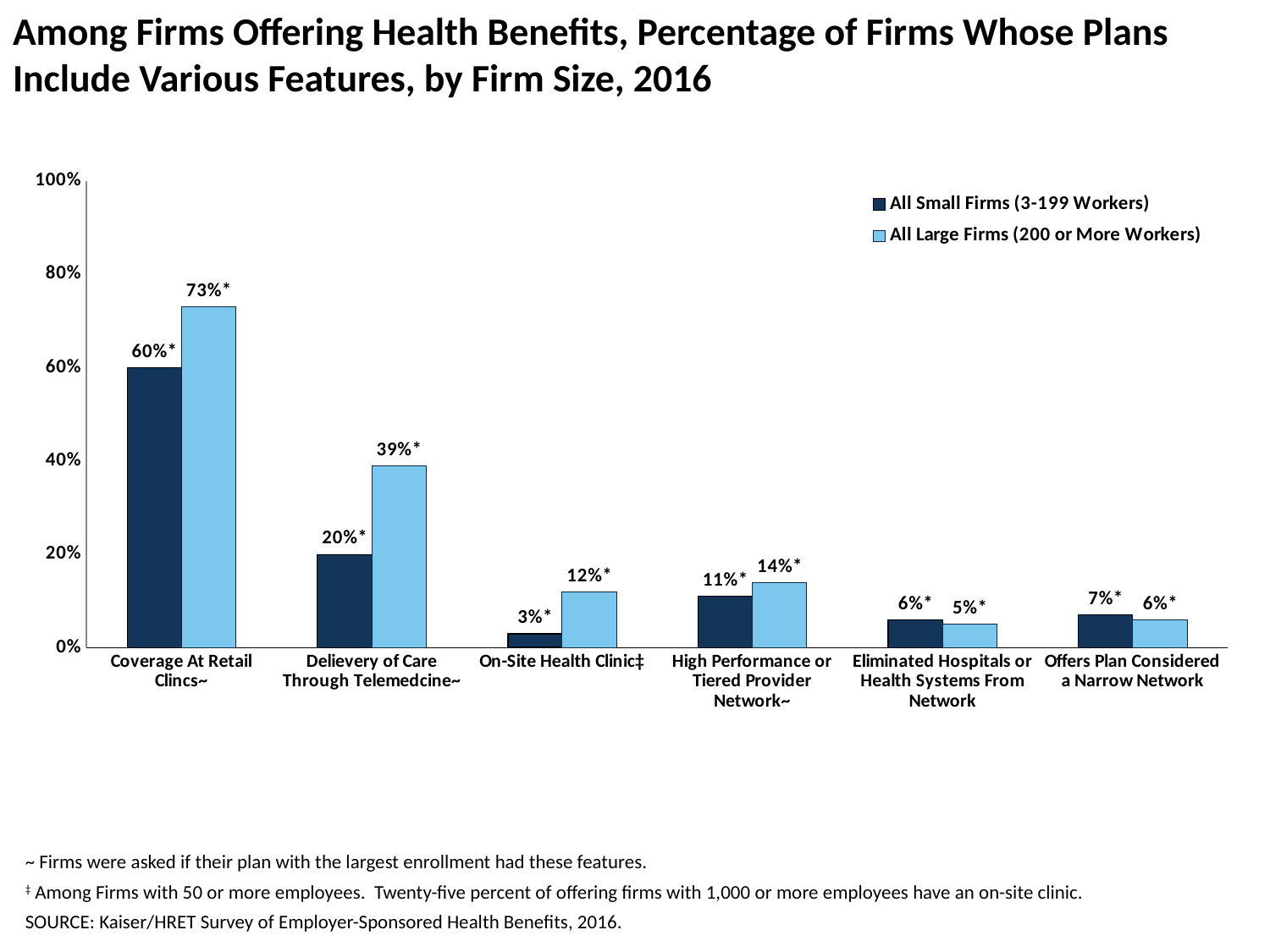
What is the total of the small firm and large firm values for eliminated hospitals or health systems from network? 11% What percentage of all small firms have an on-site health clinic? 3% What percentage of all small firms (3-199 workers) offer coverage at retail clinics? 60% Which feature has the lowest percentage among all small firms? On-Site Health Clinic What is the difference between large firms and small firms for delivery of care through telemedicine? 19 percentage points How many features (categories) are shown on the x axis? 6 How many series does the legend list? 2 What percentage of all large firms (200 or more workers) offer delivery of care through telemedicine? 39% What kind of chart is shown on the slide? Bar chart What percentage of all large firms have a high performance or tiered provider network? 14% Which feature has the highest percentage among all large firms? Coverage At Retail Clincs For offering a plan considered a narrow network, which is larger: the small firm value or the large firm value? All Small Firms (3-199 Workers)